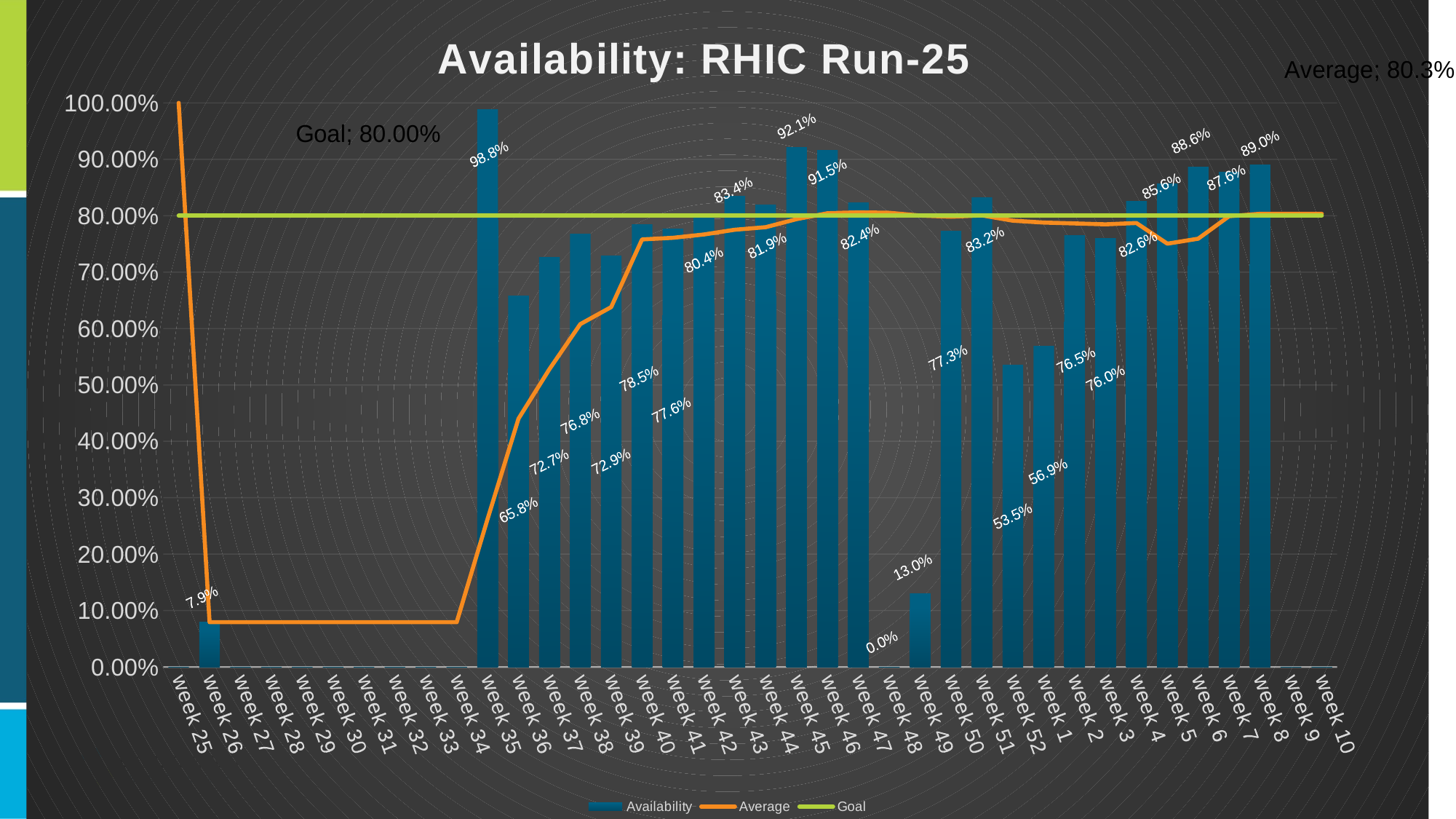
What is the difference between the availability values 92.1% and 91.5% (weeks 44 and 45)? 0.6% What kind of chart is shown on the slide? bar and line chart Is the availability for week 35 greater or less than 70.00%? greater What is the highest availability value labelled on the chart? 98.8% Which week has the highest availability? week 35 What is the Average value shown on the chart? 80.3% How many series does the legend list? 3 What is the Goal value shown on the chart? 80.00% What is the availability for week 25? 0.0% What is the availability for week 48? 0.0% What are the three legend entries? Availability, Average, Goal